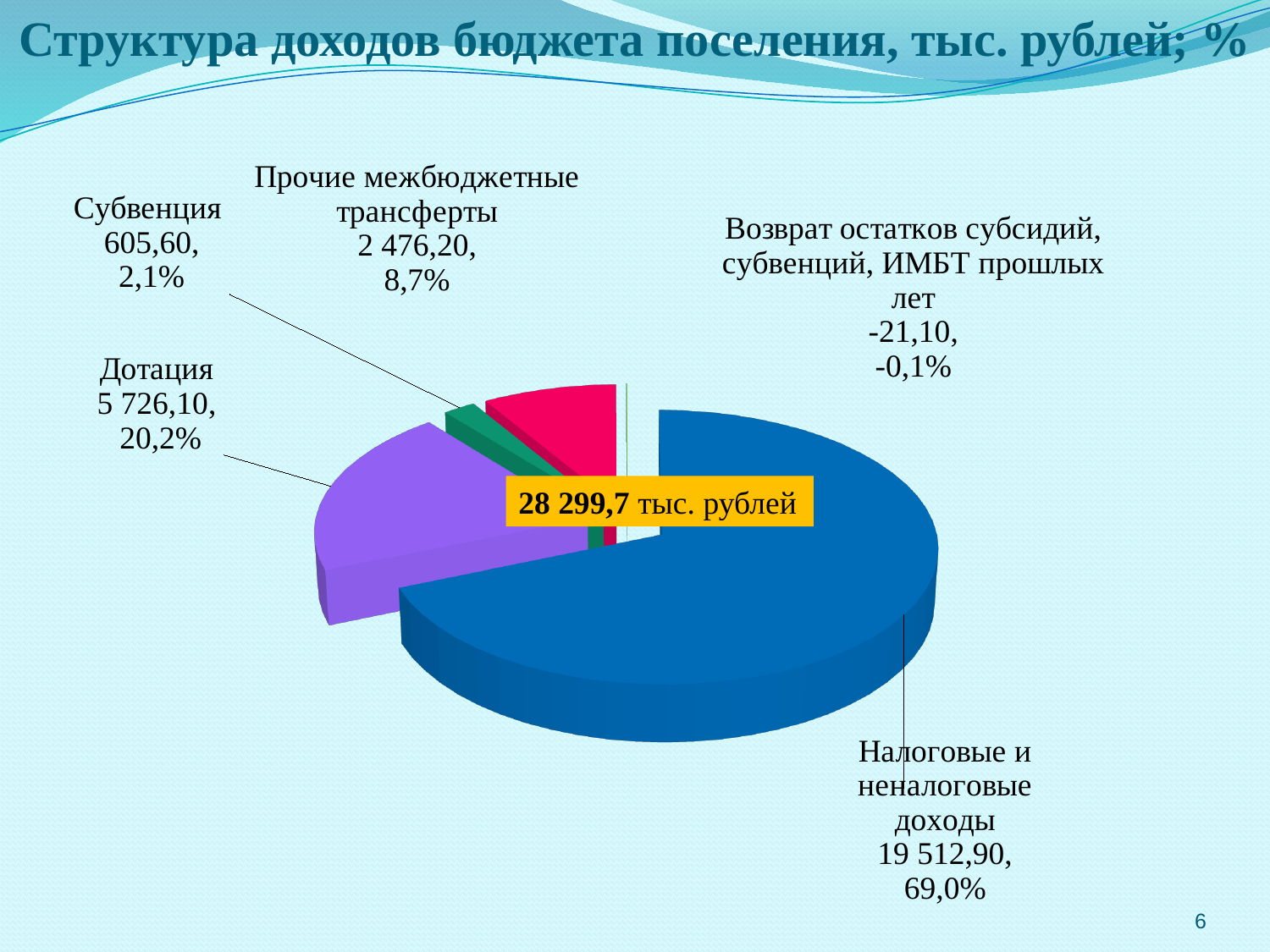
Which category has the smallest value? Возврат остатков субсидий, субвенций, ИМБТ прошлых лет What is the difference between the share of Налоговые и неналоговые доходы and the share of Дотация? 48,8% What share of the pie does Субвенция represent? 2,1% Which is larger, the value for Дотация or the value for Прочие межбюджетные трансферты? Дотация Which category has the largest share of the pie? Налоговые и неналоговые доходы What total amount is shown in the label at the centre of the chart? 28 299,7 тыс. рублей What share of the pie does Дотация represent? 20,2% What is the value for Прочие межбюджетные трансферты? 2 476,20 What is the value for Налоговые и неналоговые доходы? 19 512,90 What is the value for Возврат остатков субсидий, субвенций, ИМБТ прошлых лет? -21,10 How many categories are shown in the pie chart? 5 What type of chart is shown on the slide? pie chart